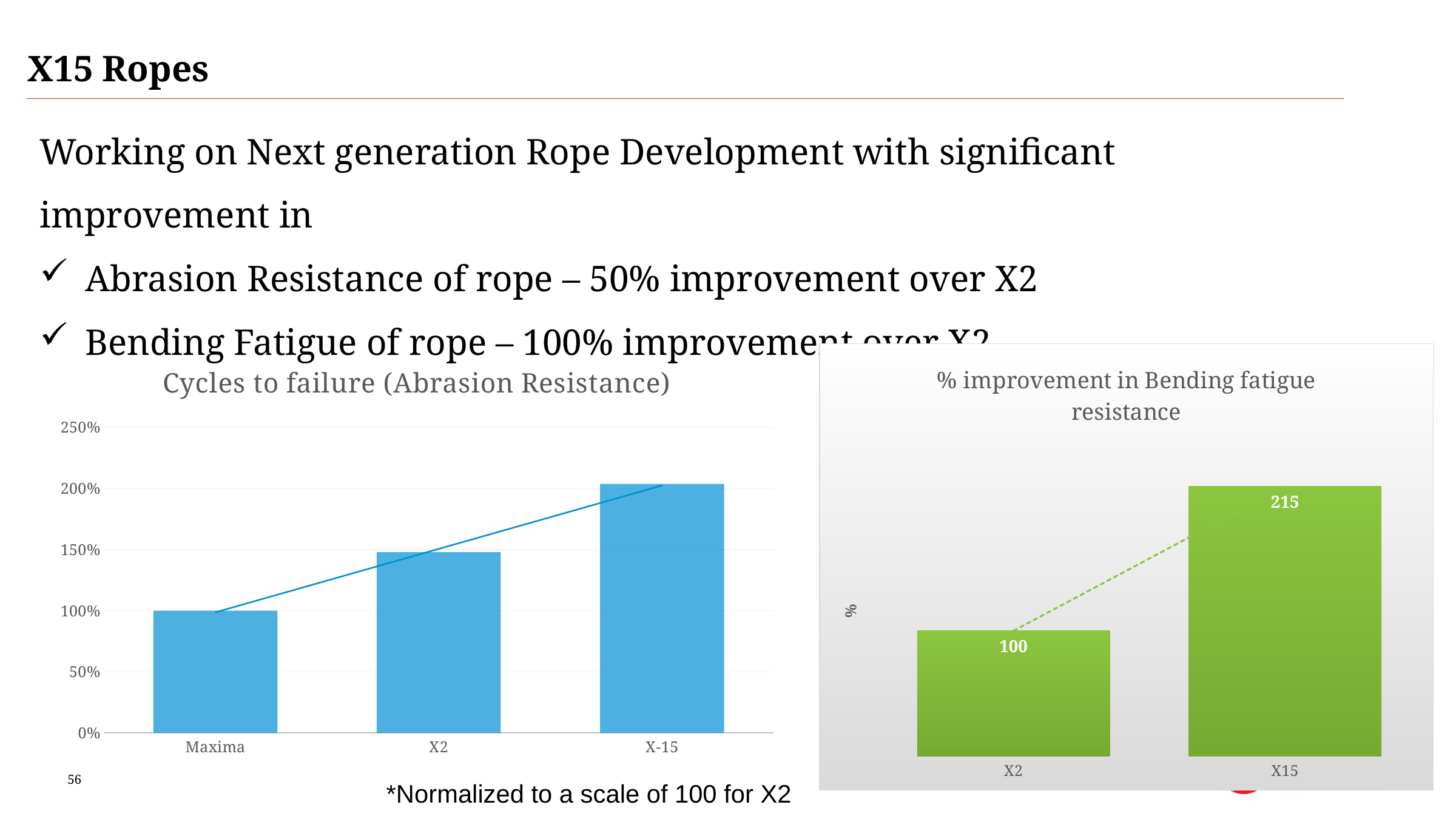
In the 'Cycles to failure (Abrasion Resistance)' chart, which category has the lowest value? Maxima In the 'Cycles to failure (Abrasion Resistance)' chart, what is the value for Maxima? 100% In the '% improvement in Bending fatigue resistance' chart, what is the difference between the values for X15 and X2? 115 In the '% improvement in Bending fatigue resistance' chart, what is the value for X2? 100 In the 'Cycles to failure (Abrasion Resistance)' chart, is the value for X2 greater or less than 100%? greater In the '% improvement in Bending fatigue resistance' chart, what is the value for X15? 215 In the 'Cycles to failure (Abrasion Resistance)' chart, what kind of chart is shown? bar chart In the 'Cycles to failure (Abrasion Resistance)' chart, which category has the highest value? X-15 In the '% improvement in Bending fatigue resistance' chart, which is larger, X2 or X15? X15 In the 'Cycles to failure (Abrasion Resistance)' chart, how many categories are shown on the x axis? 3 In the 'Cycles to failure (Abrasion Resistance)' chart, is the value for X-15 greater or less than 150%? greater In the 'Cycles to failure (Abrasion Resistance)' chart, do the values rise or fall from Maxima to X-15? rise